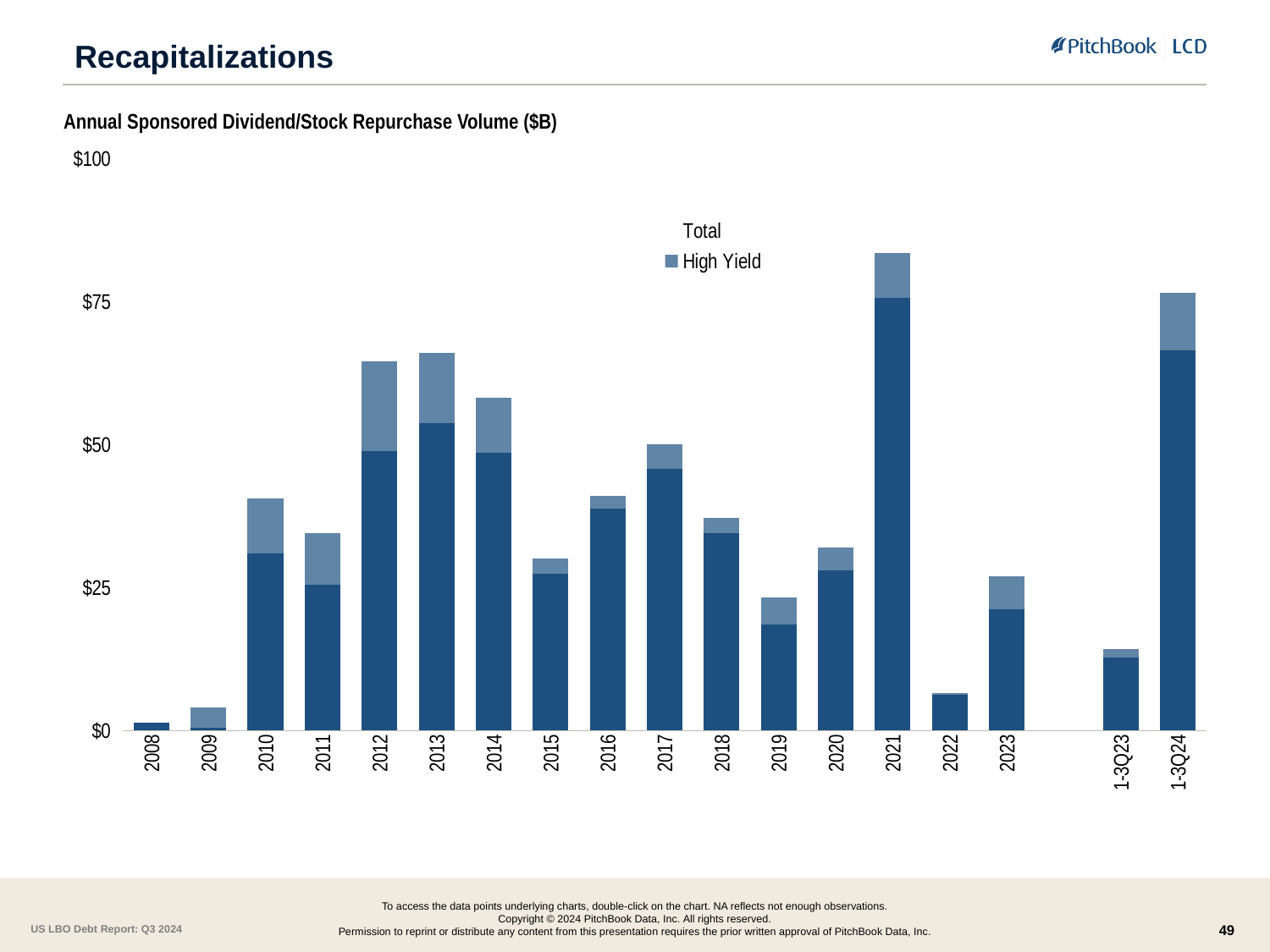
What kind of chart is shown on the slide? Stacked bar chart How many bars (periods) are plotted on the x axis? 18 Which period has the highest total volume? 2021 Is the total value for 1-3Q24 greater or less than $50? greater Is the total value for 2012 greater or less than $50? greater Which period has the lowest total volume? 2008 Do the total values rise or fall from 2017 to 2019? fall What is the title of the chart? Annual Sponsored Dividend/Stock Repurchase Volume ($B) Is the total value for 2022 greater or less than $25? less Which has the larger total volume, 2013 or 2014? 2013 How many entries does the chart legend list? 2